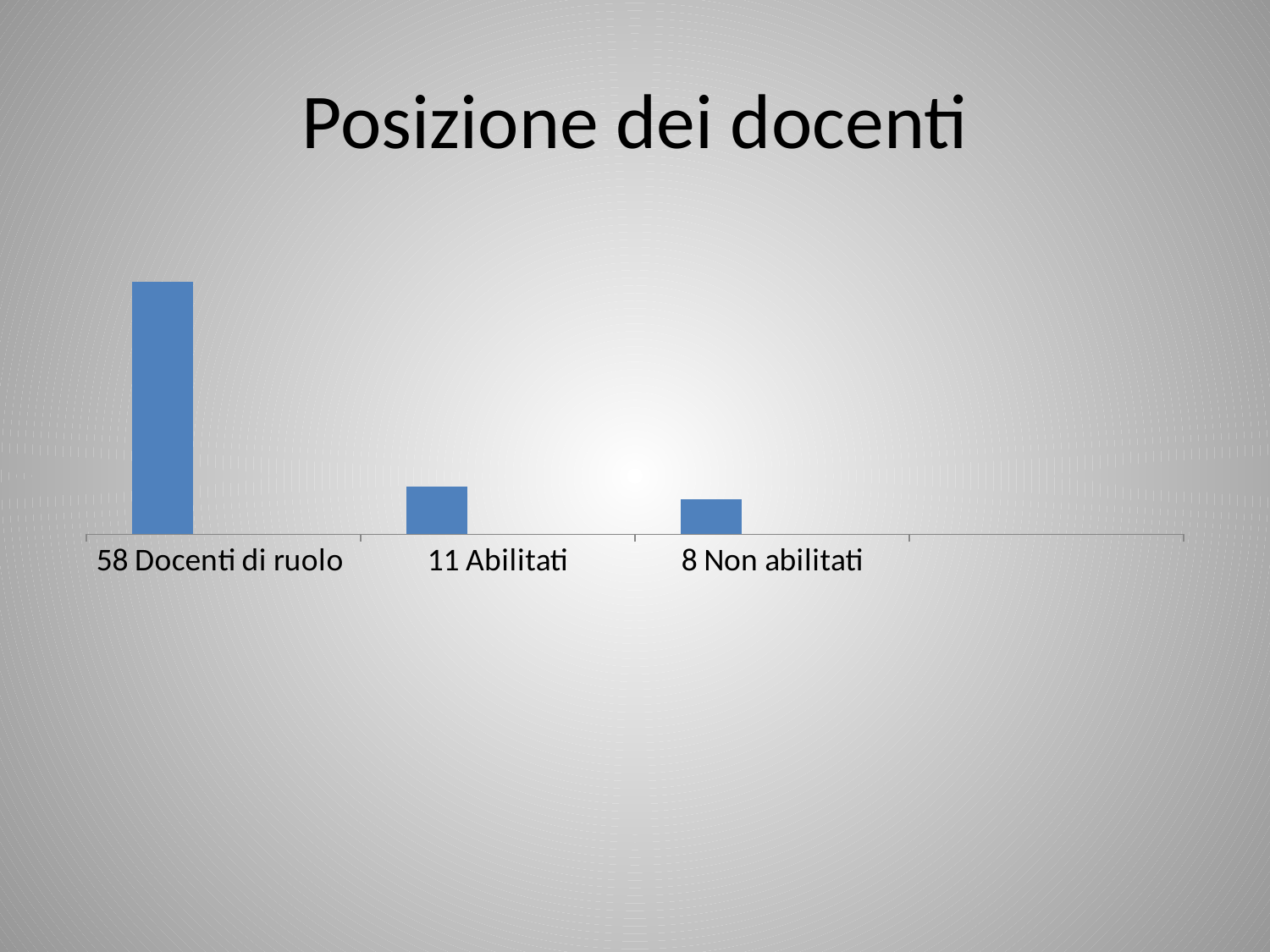
Do the bar values rise or fall from left to right along the x axis? fall What is the difference between the number of Docenti di ruolo and the number of Abilitati? 47 Which category has the lowest bar? Non abilitati How many Non abilitati are shown in the chart? 8 What is the difference between the number of Abilitati and the number of Non abilitati? 3 Which is larger, the value for Abilitati or the value for Non abilitati? Abilitati How many Abilitati are shown in the chart? 11 Which category has the highest bar? Docenti di ruolo How many bars are plotted in the chart? 3 How many Docenti di ruolo are shown in the chart? 58 What kind of chart is shown on the slide? bar chart What is the title of the chart? Posizione dei docenti